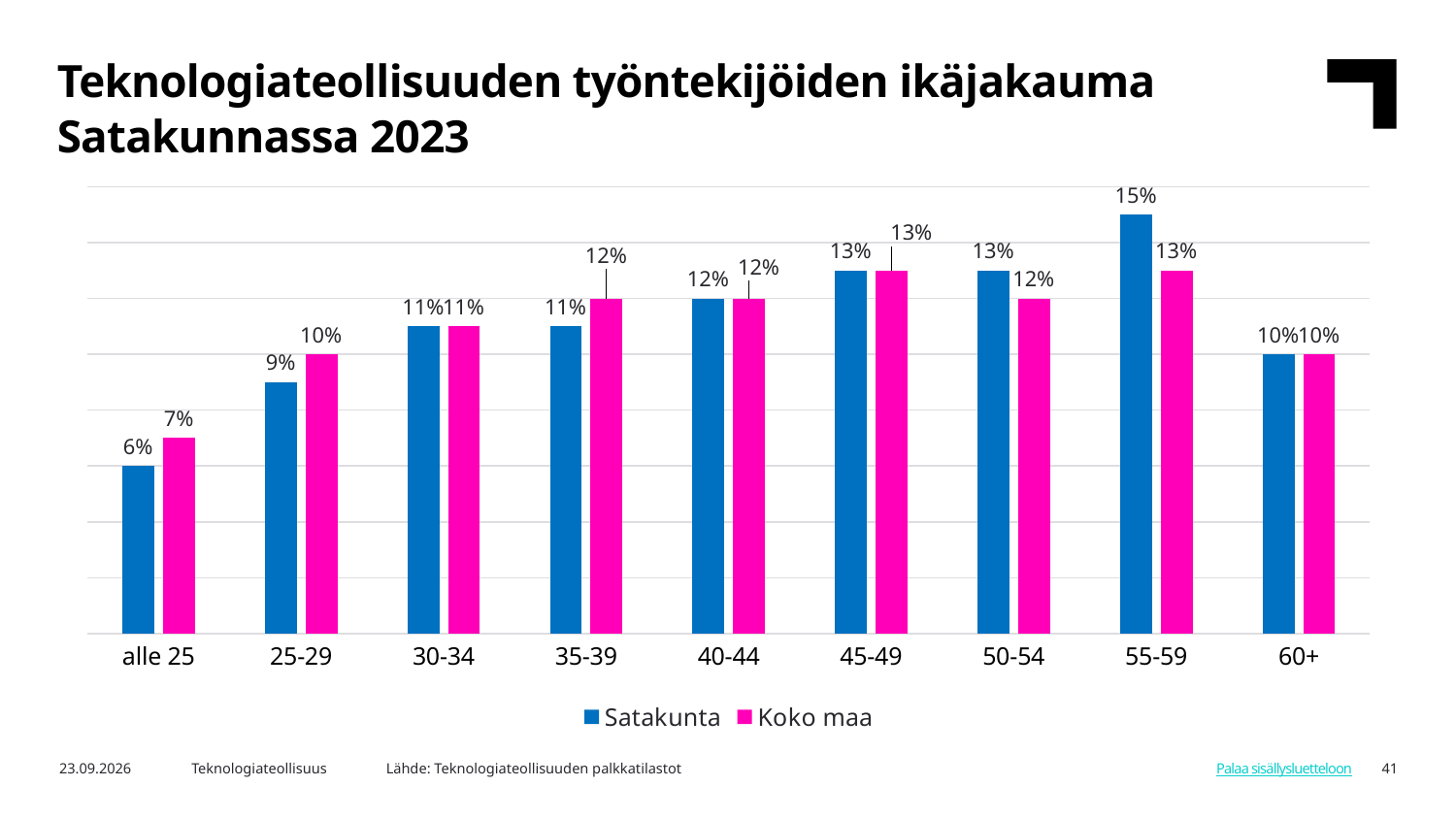
Do the Satakunta values rise or fall from the alle 25 group to the 55-59 group? Rise What is the Satakunta value for the 25-29 age group? 9% How many age groups are shown on the x axis? 9 What is the Koko maa value for the alle 25 age group? 7% Which age group has the highest Satakunta value? 55-59 How many series does the legend list? 2 Which age group has the lowest Koko maa value? alle 25 For the 25-29 age group, which is larger: the Satakunta value or the Koko maa value? Koko maa Which series is shown in pink in the legend? Koko maa What is the difference between the Satakunta and Koko maa values for the 55-59 age group? 2% What kind of chart is shown on the slide? Bar chart What is the Satakunta value for the 55-59 age group? 15%